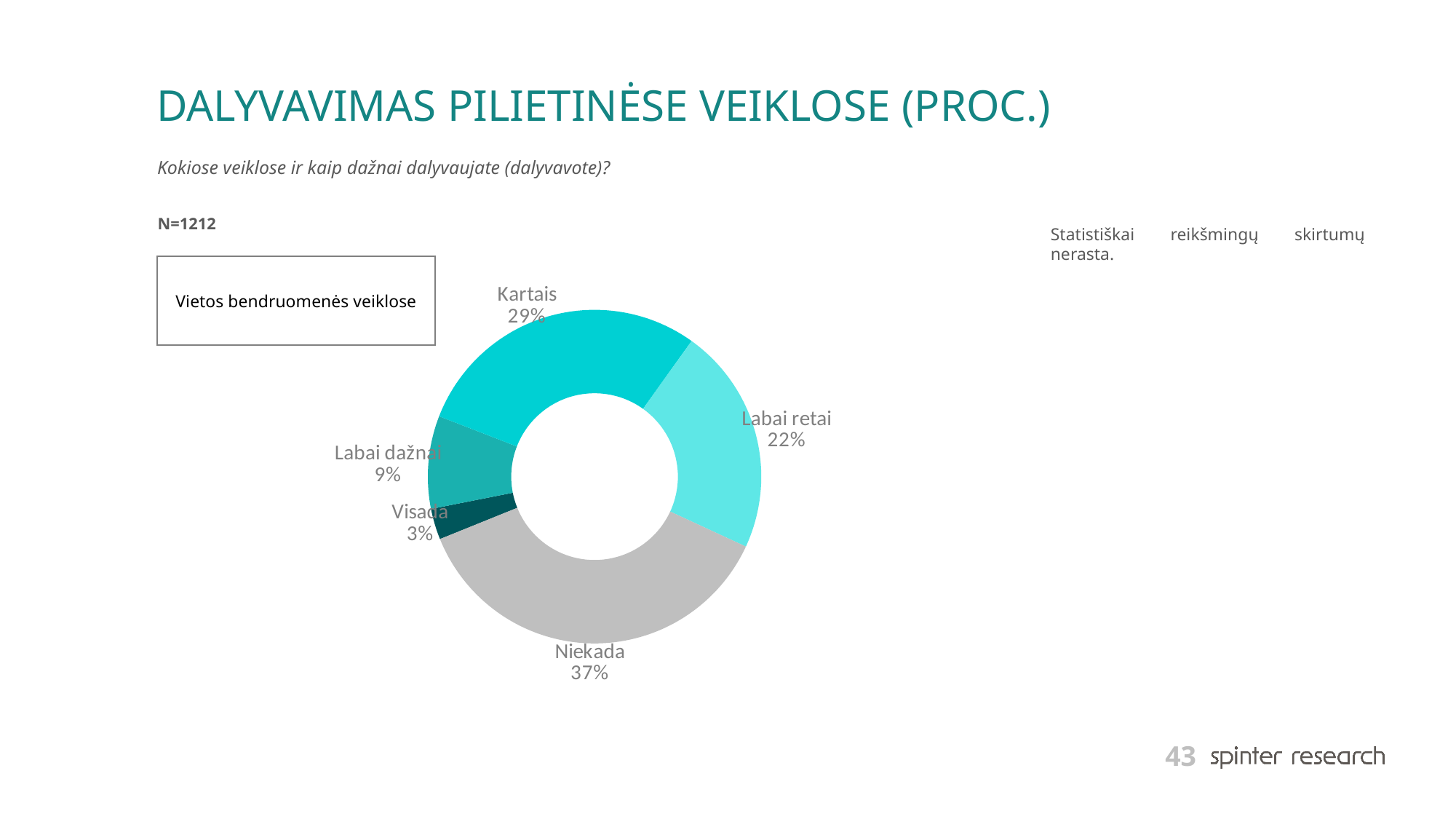
What kind of chart is shown on the slide? Doughnut (pie) chart Which category has the smallest share of the chart? Visada Which is larger, the share for "Labai retai" or the share for "Labai dažnai"? Labai retai Which category has the largest share of the chart? Niekada What percentage of respondents answered "Niekada"? 37% What percentage of respondents answered "Labai dažnai"? 9% What is the difference in percentage points between "Niekada" and "Kartais"? 8 What percentage of respondents answered "Kartais"? 29% What percentage of respondents answered "Visada"? 3% What is the sample size (N) stated on the slide? N=1212 What percentage of respondents answered "Labai retai"? 22% How many categories are shown in the chart? 5